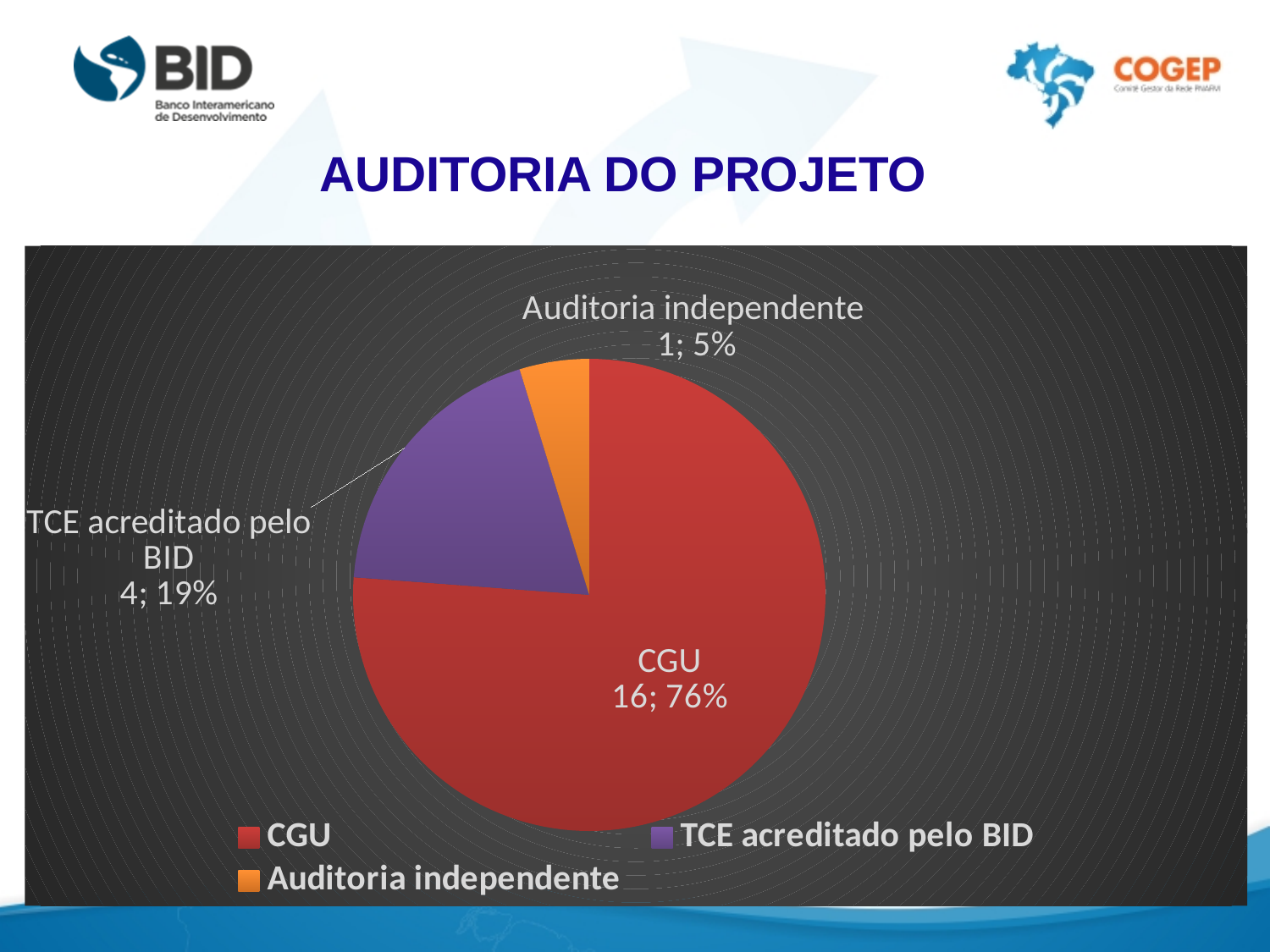
What colour is the slice for Auditoria independente? orange What is the value shown for Auditoria independente? 1 How many entries does the legend list? 3 What kind of chart is shown on the slide? pie chart Which category has the largest slice? CGU What is the value shown for TCE acreditado pelo BID? 4 What is the value shown for CGU? 16 How many slices does the pie chart have? 3 Which category has the smallest slice? Auditoria independente What is the difference between the values for CGU and TCE acreditado pelo BID? 12 What share of the pie does TCE acreditado pelo BID represent? 19% What share of the pie does CGU represent? 76%